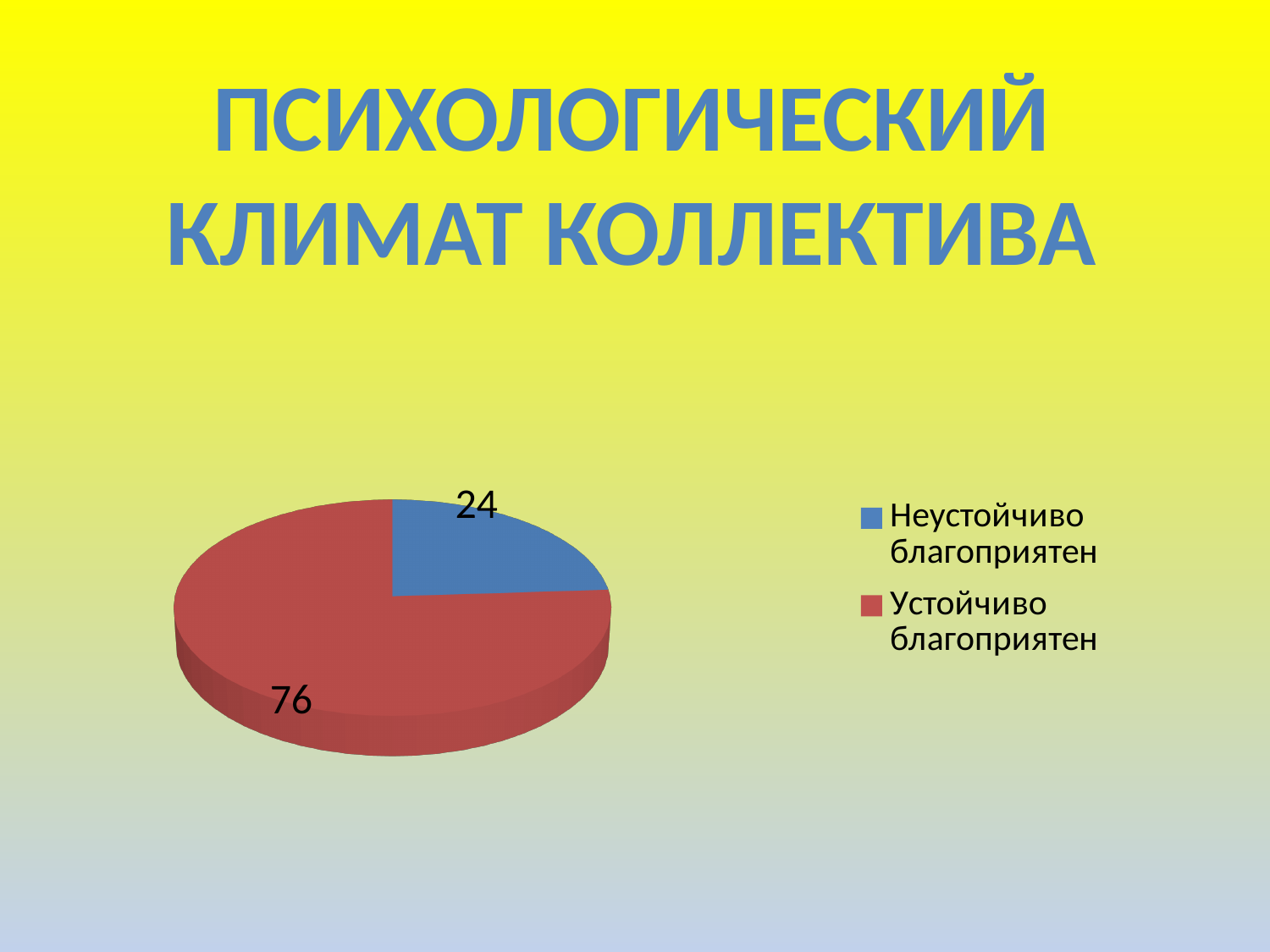
What share of the pie does "Неустойчиво благоприятен" represent? 24% What colour is the slice for "Устойчиво благоприятен"? red Which is larger: the value for "Устойчиво благоприятен" or for "Неустойчиво благоприятен"? Устойчиво благоприятен How many entries does the legend list? 2 Which category has the largest slice of the pie? Устойчиво благоприятен What is the value for "Неустойчиво благоприятен"? 24 What is the total of the two values shown on the pie chart? 100 How many slices does the pie chart have? 2 What is the value for "Устойчиво благоприятен"? 76 Which category has the smallest slice of the pie? Неустойчиво благоприятен What is the difference between the values for "Устойчиво благоприятен" and "Неустойчиво благоприятен"? 52 What kind of chart is shown on the slide? pie chart